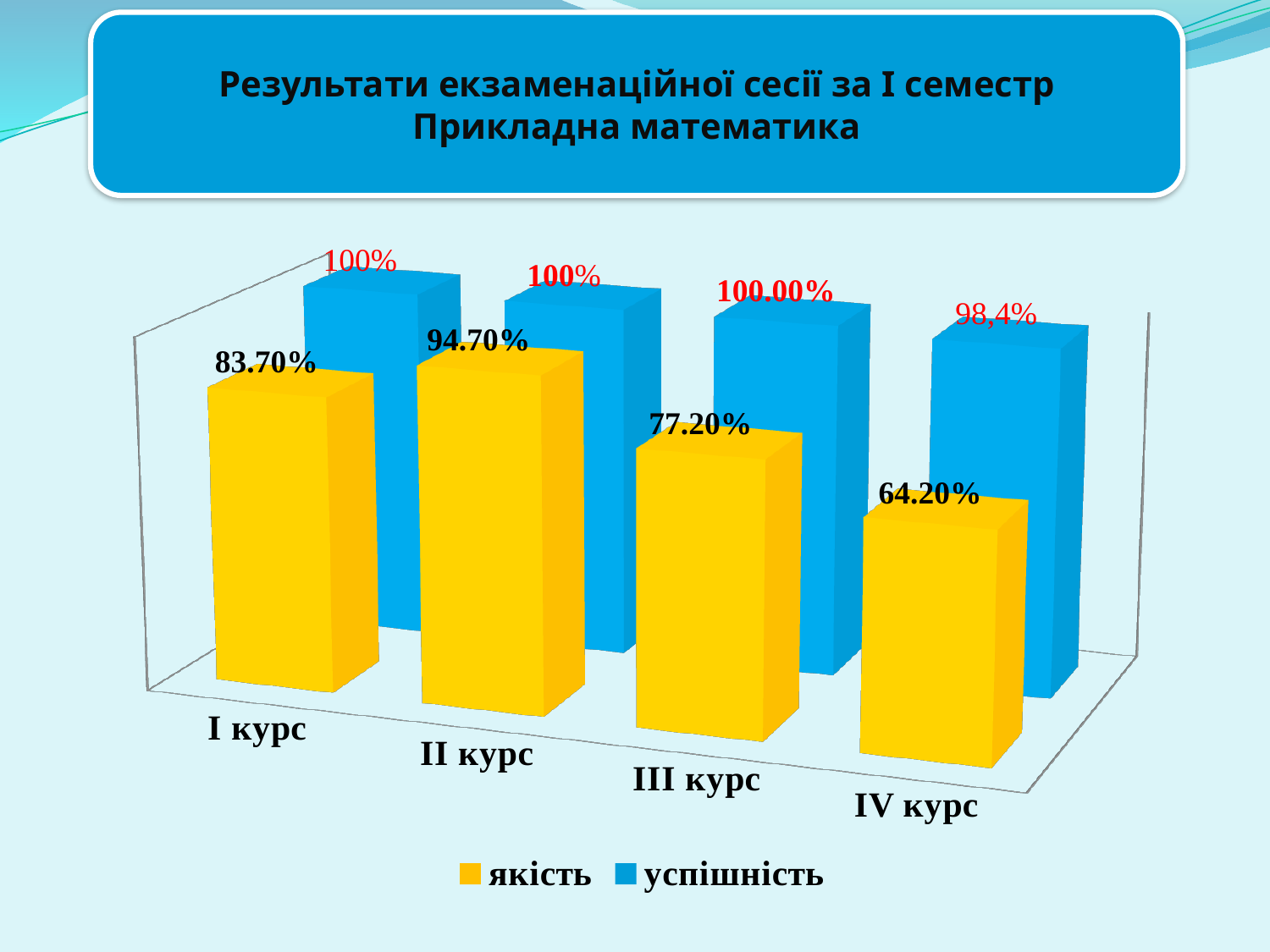
Which is larger, the якість value for I курс or for III курс? I курс Which course has the lowest успішність value? IV курс Which course has the lowest якість value? IV курс What is the value of успішність for IV курс? 98,4% Which course has the highest якість value? II курс How many courses (categories) are shown on the x axis? 4 What is the value of якість for II курс? 94.70% What is the value of якість for I курс? 83.70% What is the difference between the якість values for II курс and IV курс? 30.50% What kind of chart is shown on the slide? Bar chart How many series does the legend list? 2 What is the value of якість for IV курс? 64.20%